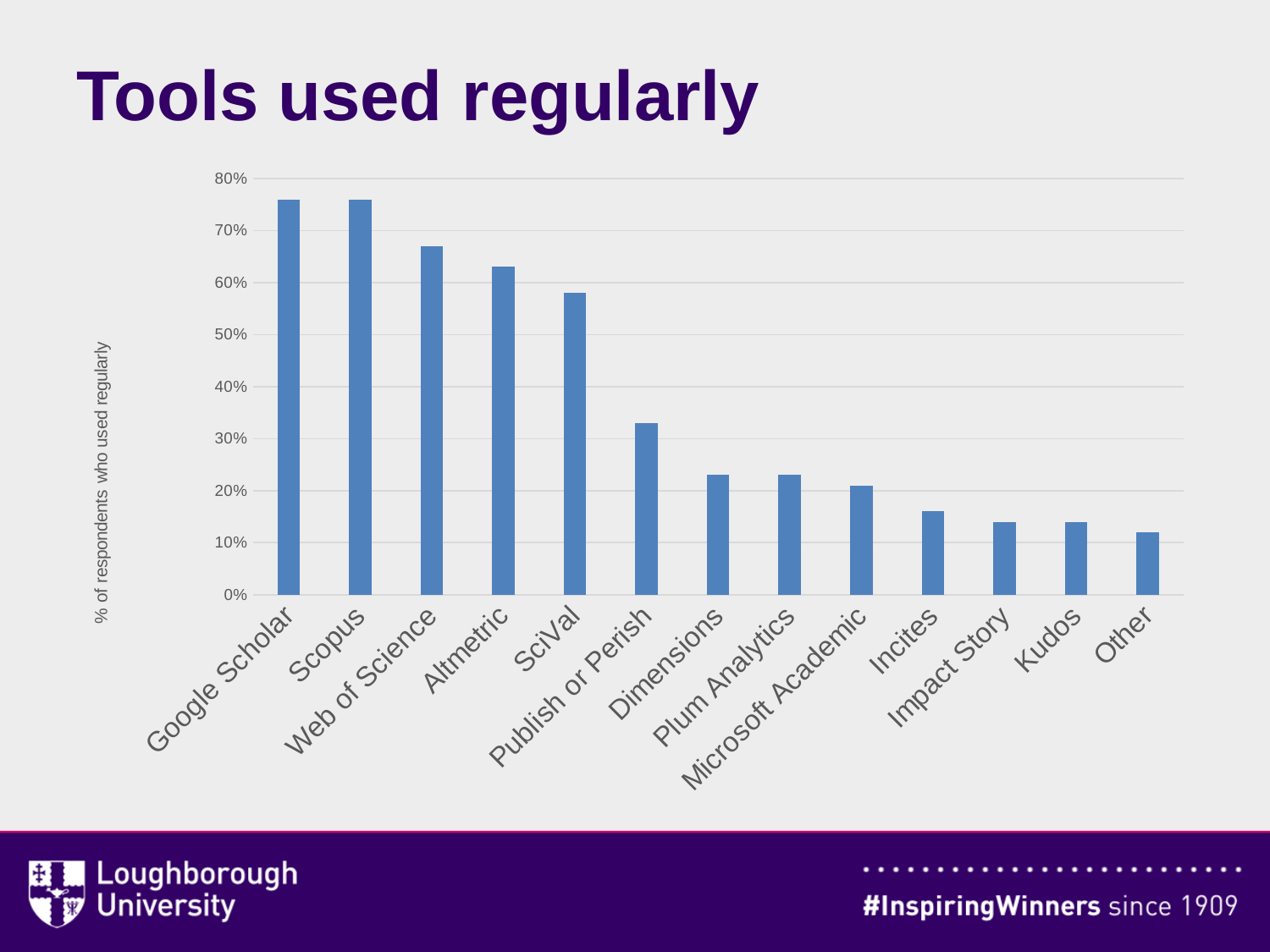
What is the label on the vertical axis of the chart? % of respondents who used regularly Which has a higher value, SciVal or Publish or Perish? SciVal Do the values generally rise or fall moving from left to right along the x axis? fall Is the value for Web of Science greater or less than 60%? greater What kind of chart is shown on the slide? bar chart How many tools (categories) are shown on the x axis of the chart? 13 Is the value for Incites greater or less than 20%? less Is the value for Publish or Perish greater or less than 40%? less Which has a higher value, Web of Science or Altmetric? Web of Science